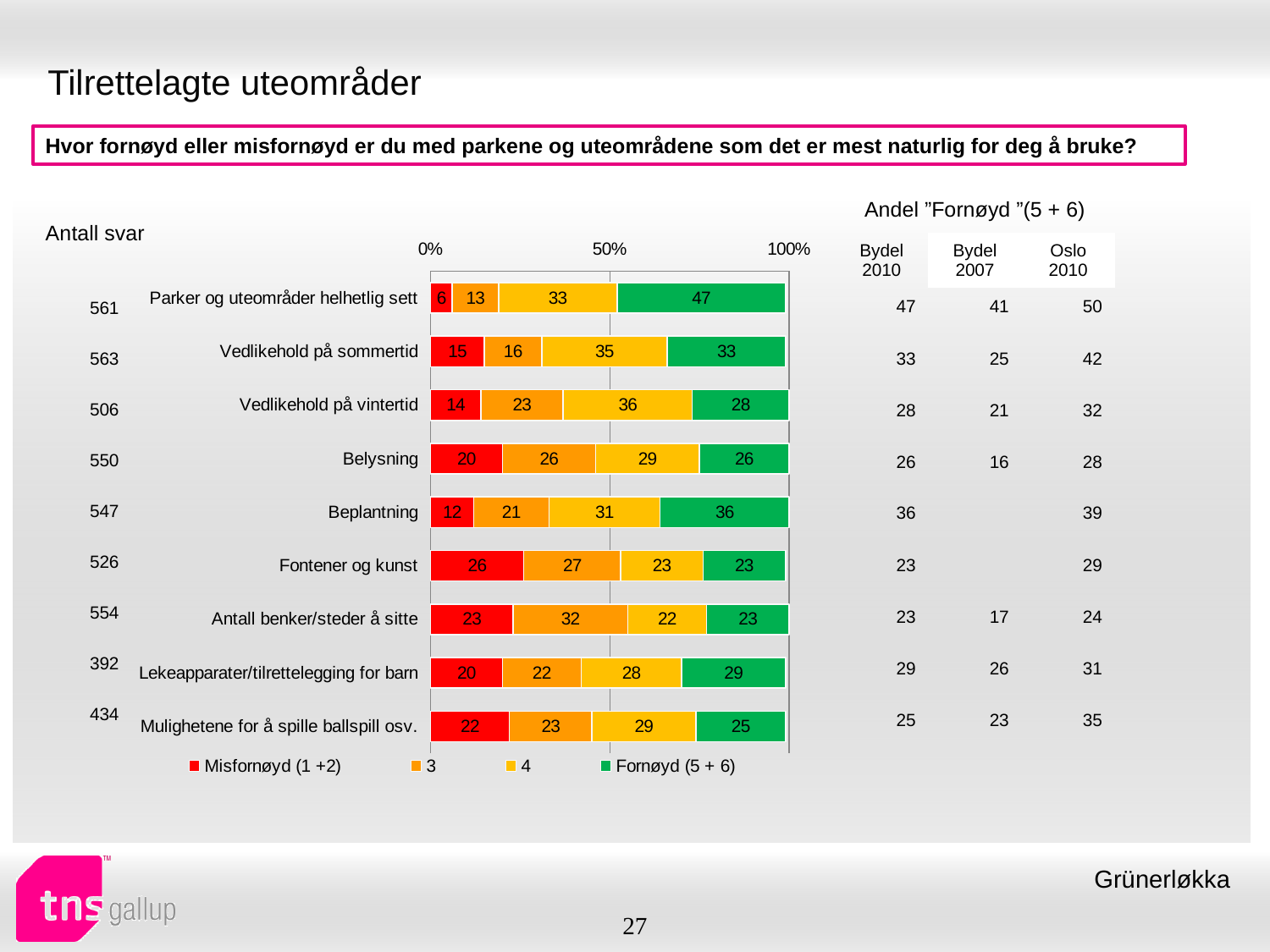
Which has a larger "Fornøyd (5 + 6)" value: "Beplantning" or "Belysning"? Beplantning What colour represents the "Fornøyd (5 + 6)" series? Green How many categories are shown in the chart? 9 What type of chart is shown on the slide? Stacked bar chart What is the value of series "3" for "Antall benker/steder å sitte"? 32 Which category has the highest "Fornøyd (5 + 6)" value? Parker og uteområder helhetlig sett How many series does the legend list? 4 What percentage of respondents are "Fornøyd (5 + 6)" with "Parker og uteområder helhetlig sett"? 47 What is the difference between the "Fornøyd (5 + 6)" values for "Vedlikehold på sommertid" and "Vedlikehold på vintertid"? 5 What is the "Misfornøyd (1 +2)" value for "Fontener og kunst"? 26 What is the total of the stacked bar for "Beplantning"? 100 Which category has the lowest "Misfornøyd (1 +2)" value? Parker og uteområder helhetlig sett